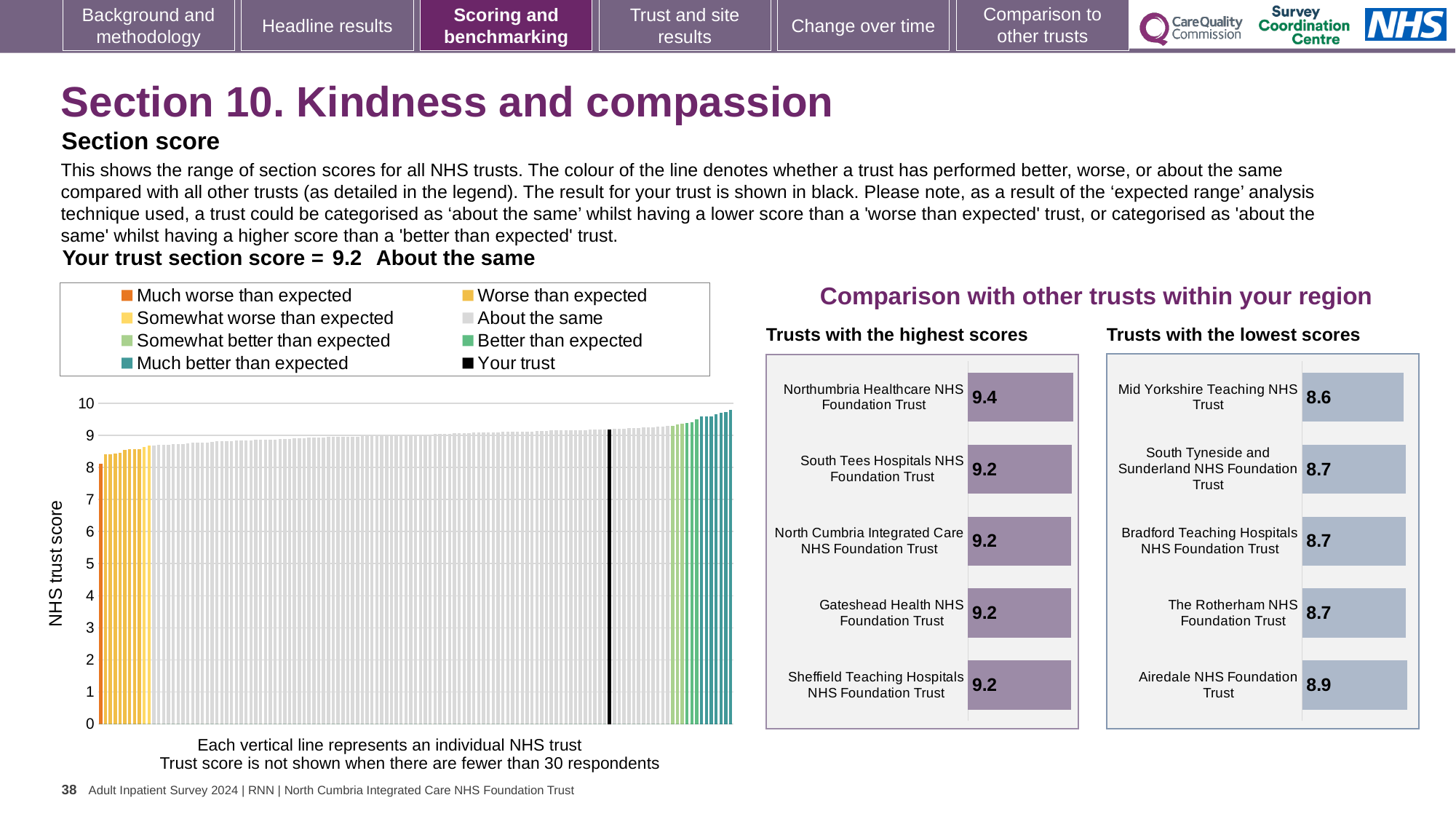
In the 'Trusts with the lowest scores' chart, what is the score for Mid Yorkshire Teaching NHS Trust? 8.6 In the 'Trusts with the lowest scores' chart, what is the difference between the scores of Airedale NHS Foundation Trust and Mid Yorkshire Teaching NHS Trust? 0.3 In the 'Trusts with the highest scores' chart, which trust has the highest score? Northumbria Healthcare NHS Foundation Trust In the 'Trusts with the lowest scores' chart, which has the larger score: Airedale NHS Foundation Trust or Bradford Teaching Hospitals NHS Foundation Trust? Airedale NHS Foundation Trust In the 'Trusts with the highest scores' chart, what is the score for Northumbria Healthcare NHS Foundation Trust? 9.4 In the 'Trusts with the lowest scores' chart, which trust has the lowest score? Mid Yorkshire Teaching NHS Trust In the 'Trusts with the lowest scores' chart, which trust has the highest score? Airedale NHS Foundation Trust In the 'Trusts with the highest scores' chart, how many trusts are shown? 5 In the 'Trusts with the highest scores' chart, what is the difference between the scores of Northumbria Healthcare NHS Foundation Trust and Gateshead Health NHS Foundation Trust? 0.2 In the large chart on the left, do the trust scores rise or fall from left to right along the x axis? Rise How many entries does the legend of the large chart on the left list? 8 What kind of chart is the large chart on the left showing the range of section scores for all NHS trusts? Bar chart